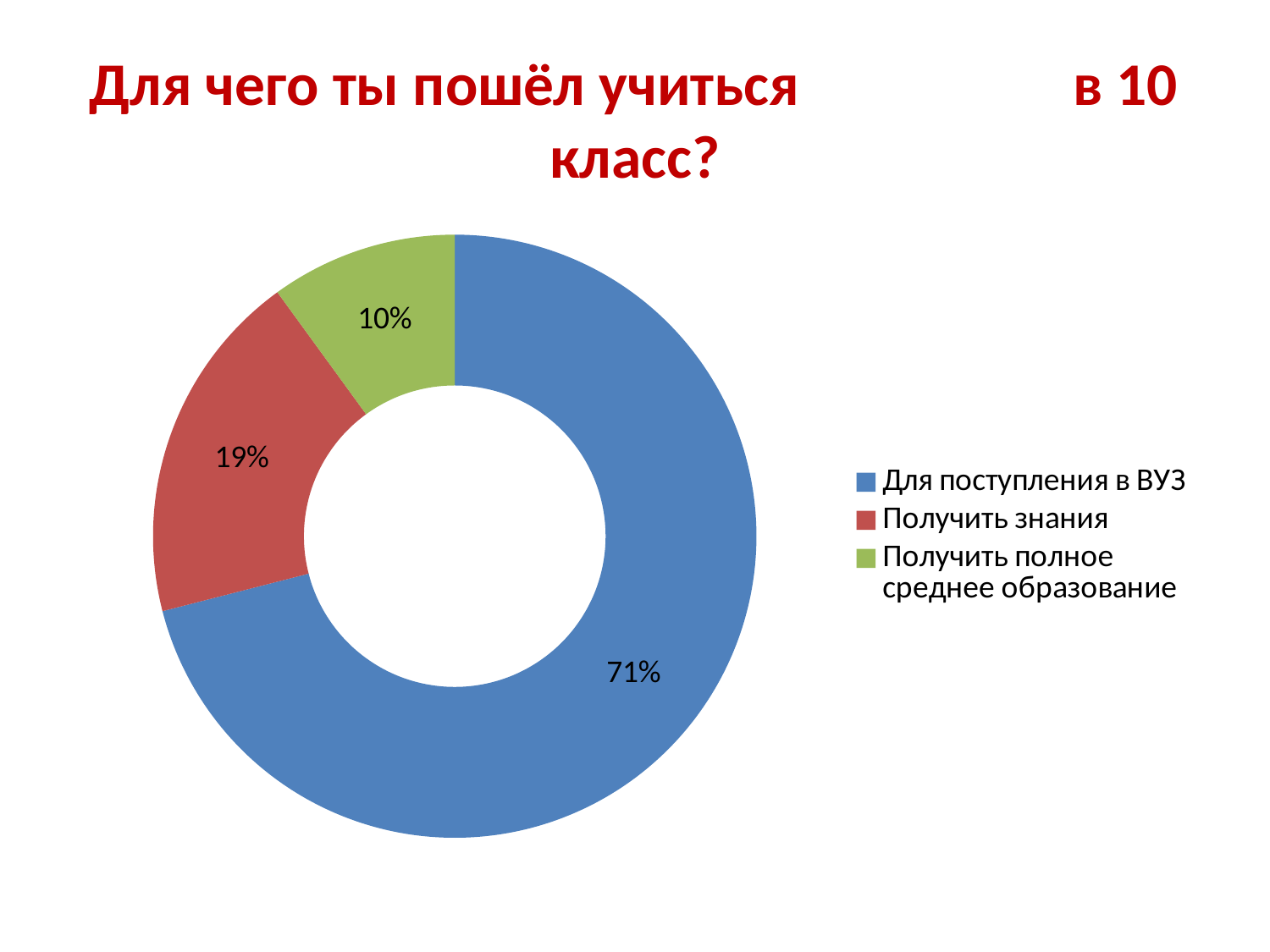
What is the title of the chart on the slide? Для чего ты пошёл учиться в 10 класс? What is the difference between the shares for 'Для поступления в ВУЗ' and 'Получить знания'? 52% What is the difference between the shares for 'Получить знания' and 'Получить полное среднее образование'? 9% Which category has the largest share of the chart? Для поступления в ВУЗ How many categories does the chart show? 3 Which is larger: the share for 'Получить знания' or for 'Получить полное среднее образование'? Получить знания What kind of chart is shown on the slide? Pie chart (doughnut) What is the value shown for 'Получить знания'? 19% What is the value shown for 'Получить полное среднее образование'? 10% What colour is the slice for 'Получить знания'? Red Which category has the smallest share of the chart? Получить полное среднее образование What share of the chart does 'Для поступления в ВУЗ' account for? 71%